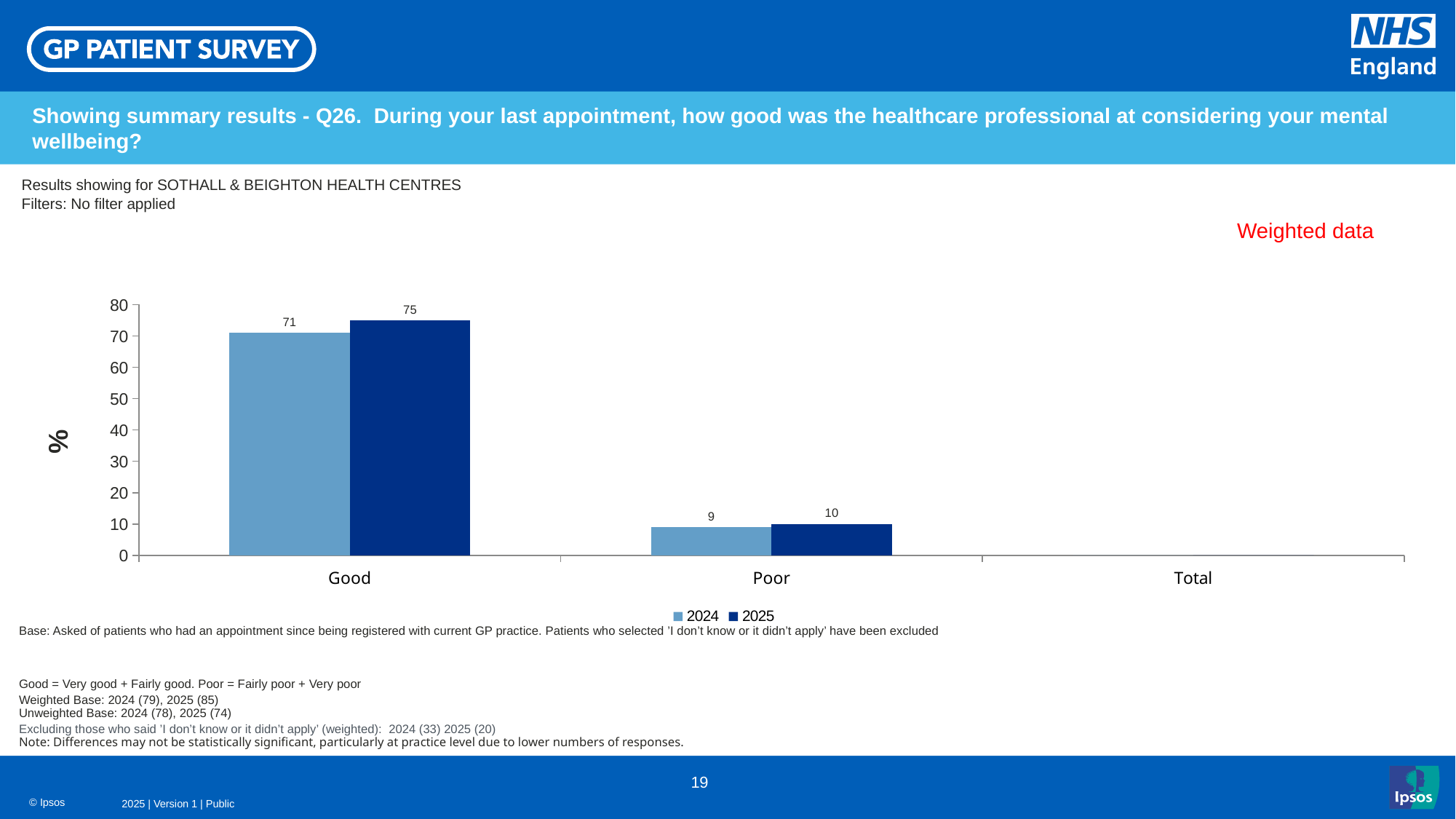
Which category has the lowest value in 2024? Poor What is the label on the vertical axis? % Is the value for Good in 2024 greater or less than 60? greater How many series does the legend list? 2 Which is larger, the 2024 value for Good or the 2025 value for Good? 2025 What kind of chart is shown on the slide? Bar chart What is the value for Poor in 2025? 10 What is the value for Good in 2024? 71 What is the difference between the 2025 and 2024 values for Good? 4 Which category has the highest value in 2025? Good What is the value for Good in 2025? 75 What is the value for Poor in 2024? 9